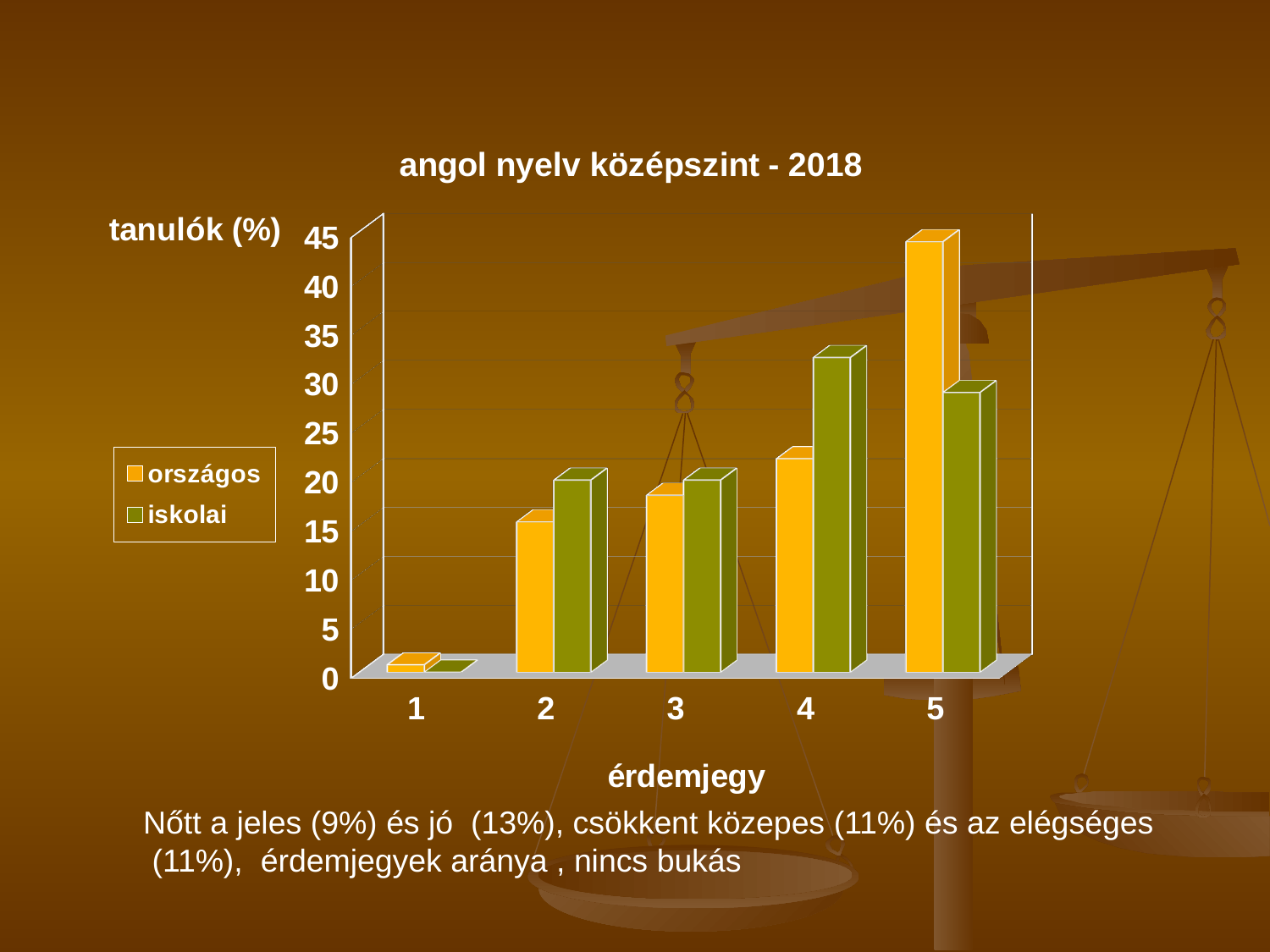
For grade 4, which series has the larger value, országos or iskolai? iskolai What is the title of the chart? angol nyelv középszint - 2018 Do the országos values rise or fall from grade 1 to grade 5? rise Is the országos value for grade 5 greater or less than 40? greater Is the iskolai value for grade 4 greater or less than 30? greater For which grade is the országos value highest? 5 For which grade is the országos value lowest? 1 Is the országos value for grade 2 greater or less than 20? less How many grade categories are shown on the x axis? 5 What is the label of the x axis? érdemjegy What kind of chart is shown on the slide? bar chart How many series does the legend list? 2